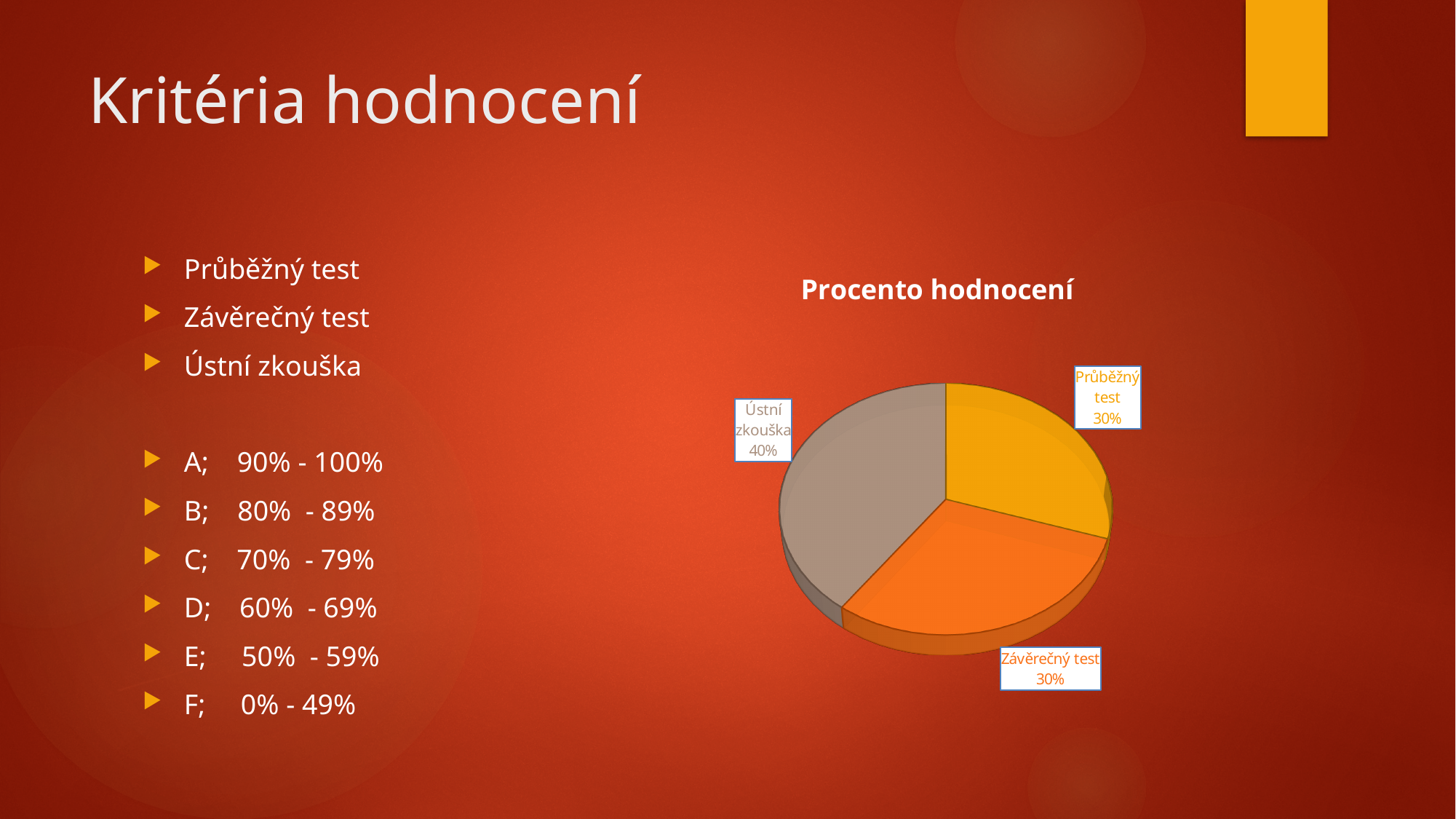
Which category has the largest slice of the pie? Ústní zkouška What is the combined share of Průběžný test and Závěrečný test? 60% What colour is the Ústní zkouška slice? grey How many slices does the pie chart have? 3 What is the title of the chart? Procento hodnocení What share of the pie does Závěrečný test have? 30% What is the difference between the share of Ústní zkouška and the share of Průběžný test? 10% What share of the pie does Ústní zkouška have? 40% What kind of chart is shown on the slide? pie chart What share of the pie does Průběžný test have? 30% Which is larger, the share of Ústní zkouška or the share of Závěrečný test? Ústní zkouška